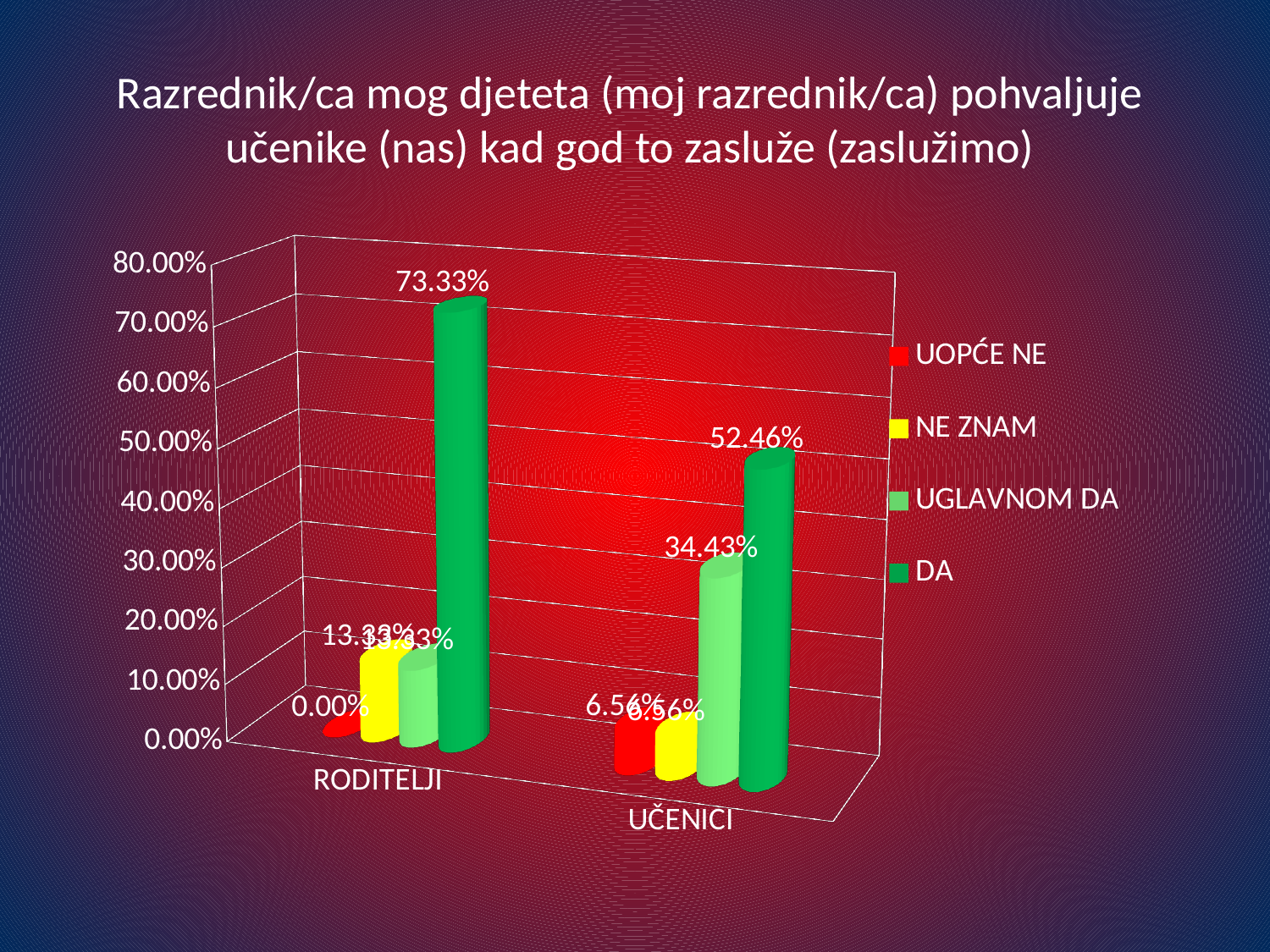
How many series does the legend list? 4 Which category has the higher value for DA, RODITELJI or UČENICI? RODITELJI Which series has the lowest value in the RODITELJI category? UOPĆE NE What is the difference between the DA values for RODITELJI and UČENICI? 20.87% What is the value for UGLAVNOM DA in the UČENICI category? 34.43% What is the value for DA in the RODITELJI category? 73.33% How many categories are shown on the x axis? 2 What is the difference between the DA and UGLAVNOM DA values in the UČENICI category? 18.03% What kind of chart is shown on the slide? bar chart Is the value for DA in the RODITELJI category greater or less than 70.00%? greater What is the value for UOPĆE NE in the RODITELJI category? 0.00% What is the value for DA in the UČENICI category? 52.46%